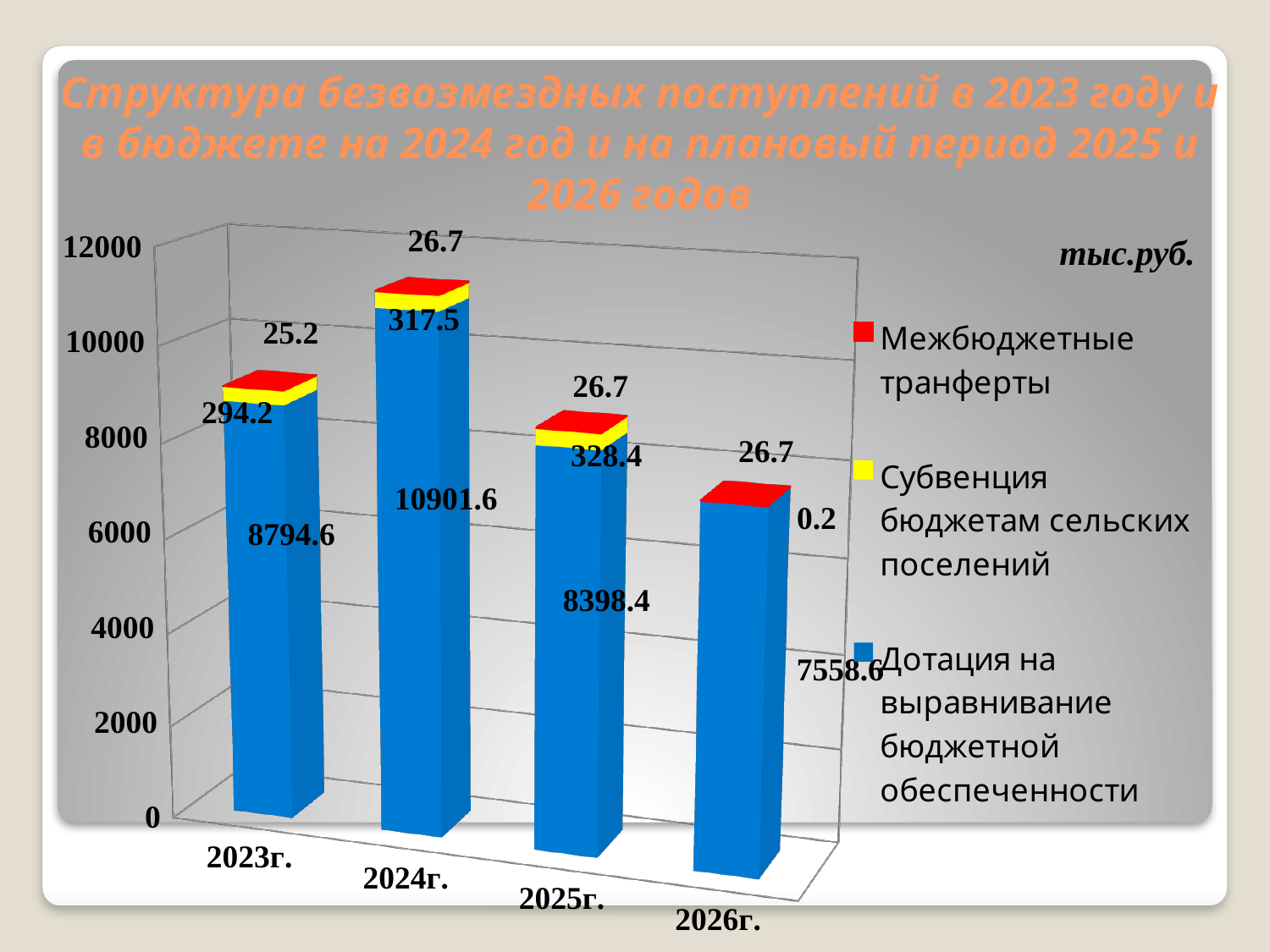
What kind of chart is shown on the slide? Stacked bar chart Which is larger: the Субвенция бюджетам сельских поселений value for 2024г. or for 2025г.? 2025г. What is the value of Межбюджетные трансферты for 2023г.? 25.2 What is the value of Дотация на выравнивание бюджетной обеспеченности for 2024г.? 10901.6 What is the value of Субвенция бюджетам сельских поселений for 2026г.? 0.2 How many series does the legend list? 3 What is the value of Субвенция бюджетам сельских поселений for 2025г.? 328.4 What is the total of the stacked bar for 2026г.? 7585.5 Which year has the highest value of Дотация на выравнивание бюджетной обеспеченности? 2024г. How many years are shown on the x axis? 4 What is the difference between the Дотация на выравнивание бюджетной обеспеченности values for 2024г. and 2023г.? 2107.0 Which year has the lowest value of Субвенция бюджетам сельских поселений? 2026г.